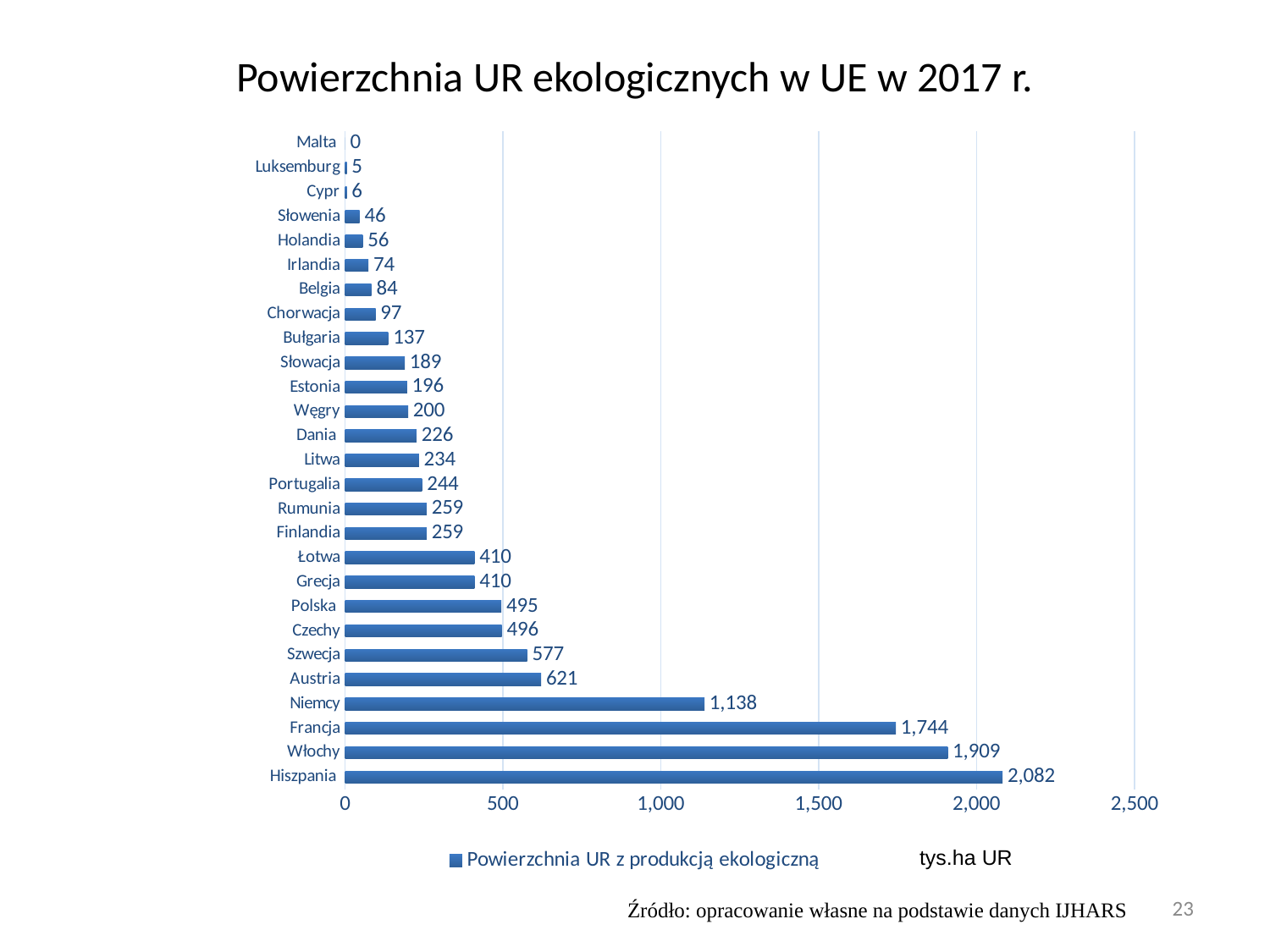
What is the difference between the values for Francja and Niemcy? 606 What is the difference between the values for Hiszpania and Włochy? 173 What is the legend entry of the chart? Powierzchnia UR z produkcją ekologiczną Is the value for Włochy greater or less than 1,500? greater Which is larger, the value for Austria or the value for Szwecja? Austria How many countries are shown in the chart? 27 What is the value for Chorwacja? 97 Which country has the highest value? Hiszpania What kind of chart is shown on the slide? bar chart Which country has the lowest value? Malta What is the value for Polska? 495 What is the value for Niemcy? 1,138